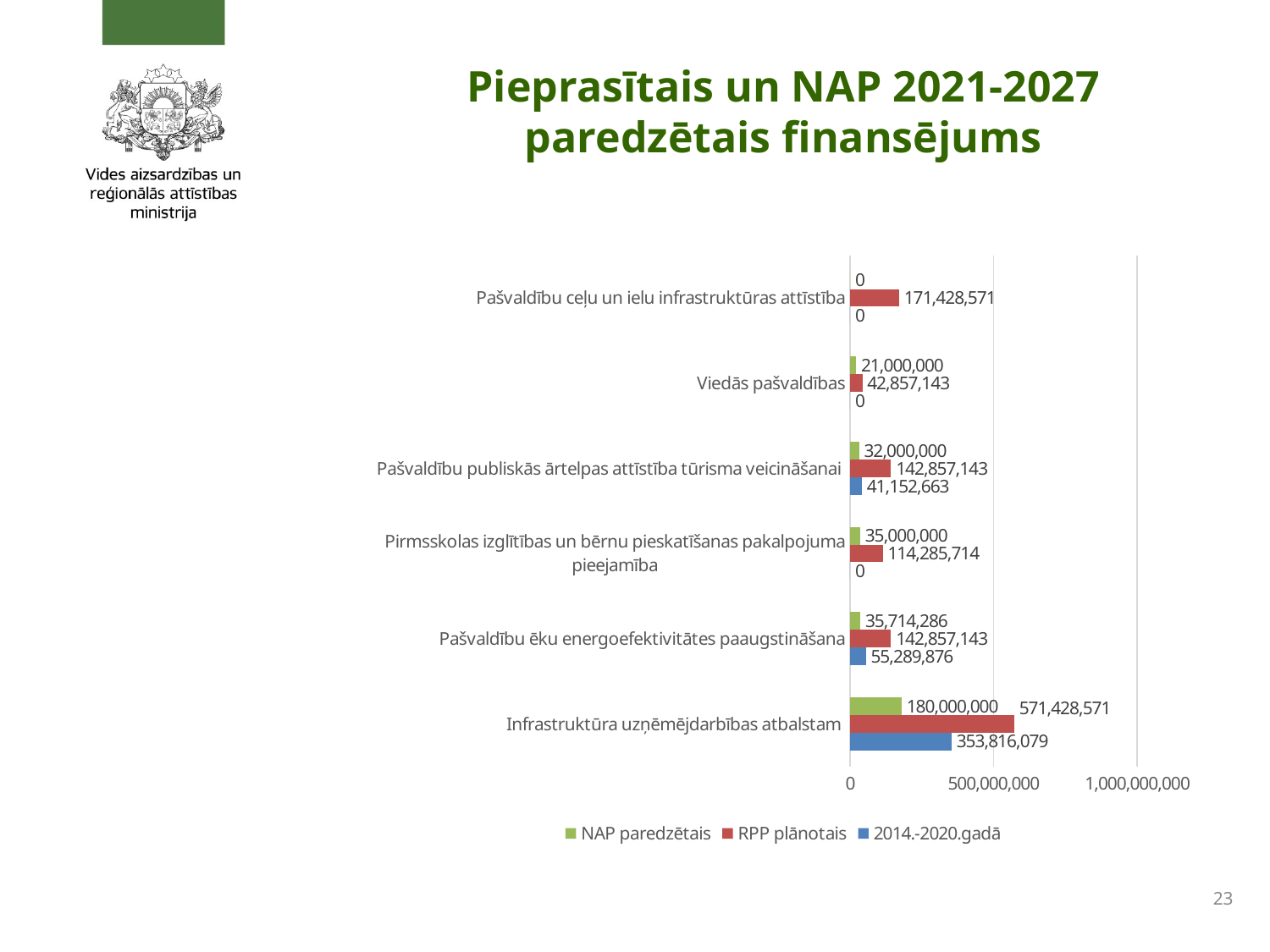
What is the 2014.-2020.gadā value for Pašvaldību ēku energoefektivitātes paaugstināšana? 55,289,876 Which category has the highest RPP plānotais value? Infrastruktūra uzņēmējdarbības atbalstam What is the RPP plānotais value for Infrastruktūra uzņēmējdarbības atbalstam? 571,428,571 How many categories are shown on the chart? 6 What is the NAP paredzētais value for Viedās pašvaldības? 21,000,000 Is the 2014.-2020.gadā value for Infrastruktūra uzņēmējdarbības atbalstam greater or less than 500,000,000? less What kind of chart is shown on the slide? bar chart Which is larger for Pirmsskolas izglītības un bērnu pieskatīšanas pakalpojuma pieejamība: the NAP paredzētais value or the RPP plānotais value? RPP plānotais How many series does the legend list? 3 Which category has the lowest RPP plānotais value? Viedās pašvaldības What is the RPP plānotais value for Pašvaldību ceļu un ielu infrastruktūras attīstība? 171,428,571 What is the difference between the RPP plānotais and NAP paredzētais values for Infrastruktūra uzņēmējdarbības atbalstam? 391,428,571